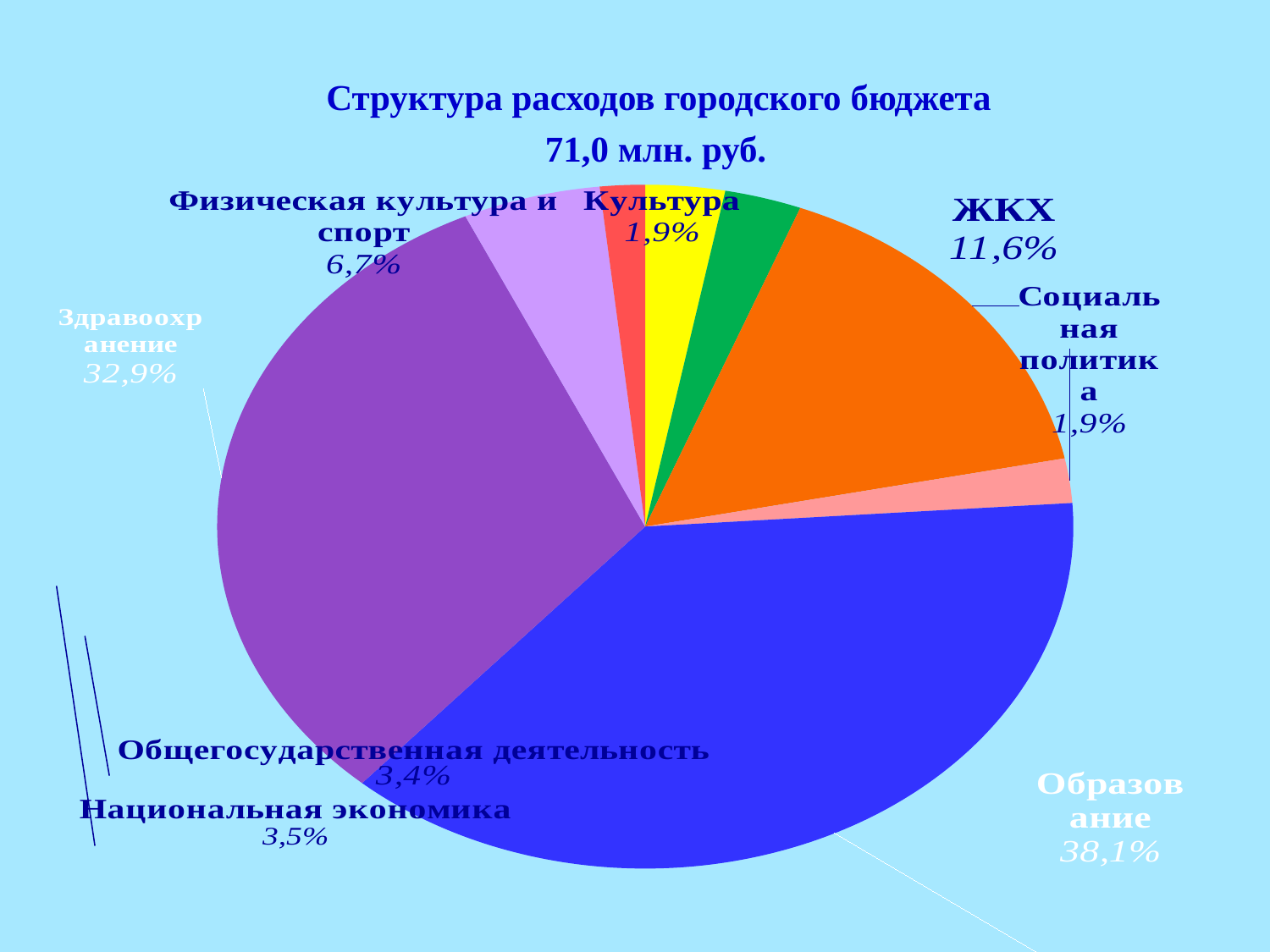
What is the value shown for ЖКХ? 11,6% What is the value shown for Национальная экономика? 3,5% What kind of chart is shown on the slide? pie chart What is the title of the chart? Структура расходов городского бюджета 71,0 млн. руб. What is the difference in percentage points between ЖКХ and Культура? 9,7 What share of the budget expenditure goes to Образование? 38,1% How many slices does the pie chart have? 8 What is the value shown for Физическая культура и спорт? 6,7% What is the difference in percentage points between Образование and Здравоохранение? 5,2 Which is larger, the share for ЖКХ or the share for Физическая культура и спорт? ЖКХ Which category has the largest share of expenditure? Образование What share of the budget expenditure goes to Здравоохранение? 32,9%